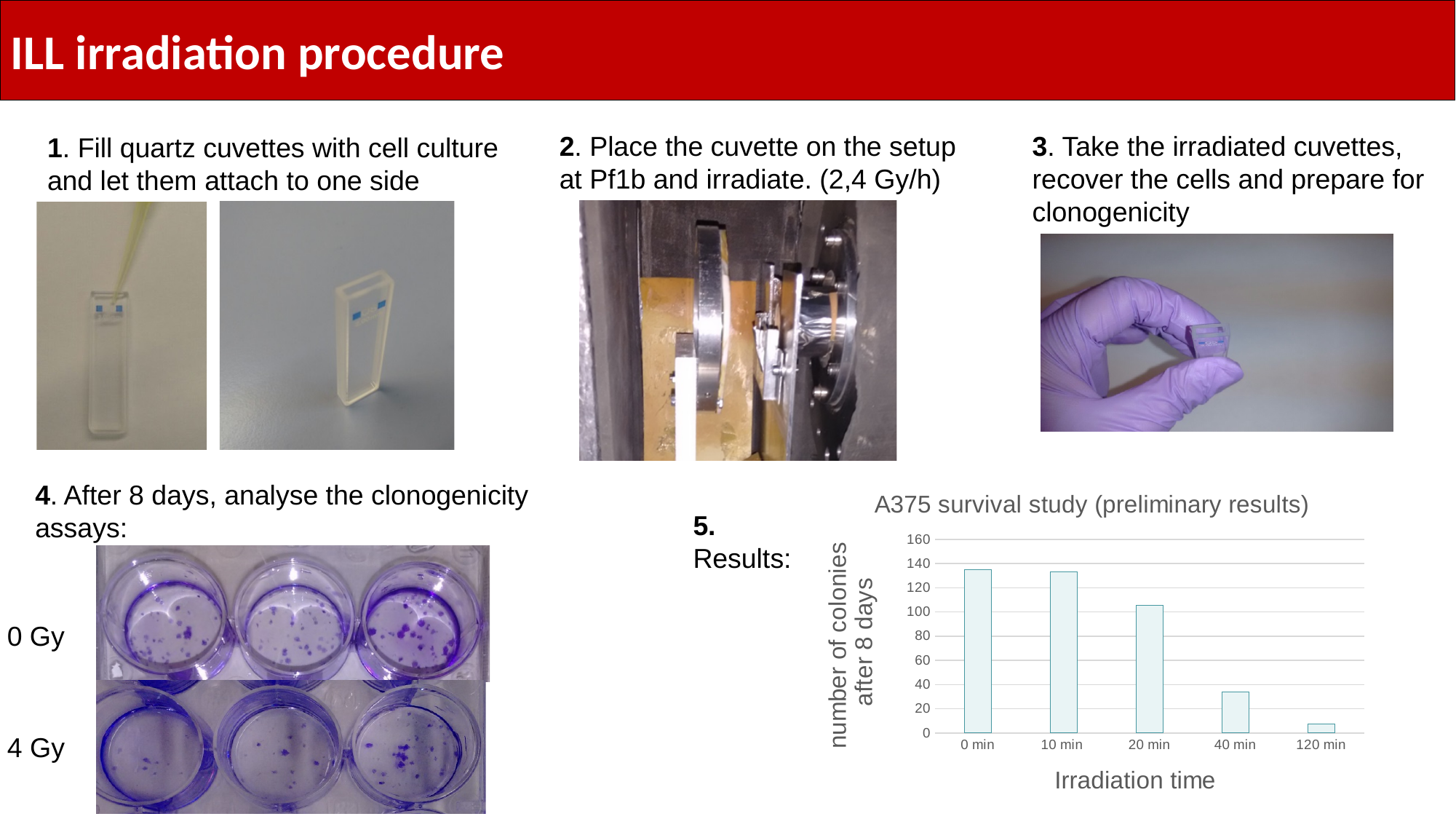
Is the number of colonies for 0 min greater or less than 120? greater What is the title of the chart? A375 survival study (preliminary results) Which irradiation time has the lowest number of colonies after 8 days? 120 min What is the label of the x axis of the chart? Irradiation time What kind of chart is shown on the slide? bar chart Is the number of colonies for 40 min greater or less than 60? less Is the number of colonies for 120 min greater or less than 20? less Do the number of colonies rise or fall as irradiation time increases along the x axis? fall Which has more colonies after 8 days, 20 min or 40 min of irradiation? 20 min Which has more colonies after 8 days, 10 min or 120 min of irradiation? 10 min How many irradiation time categories are plotted in the chart? 5